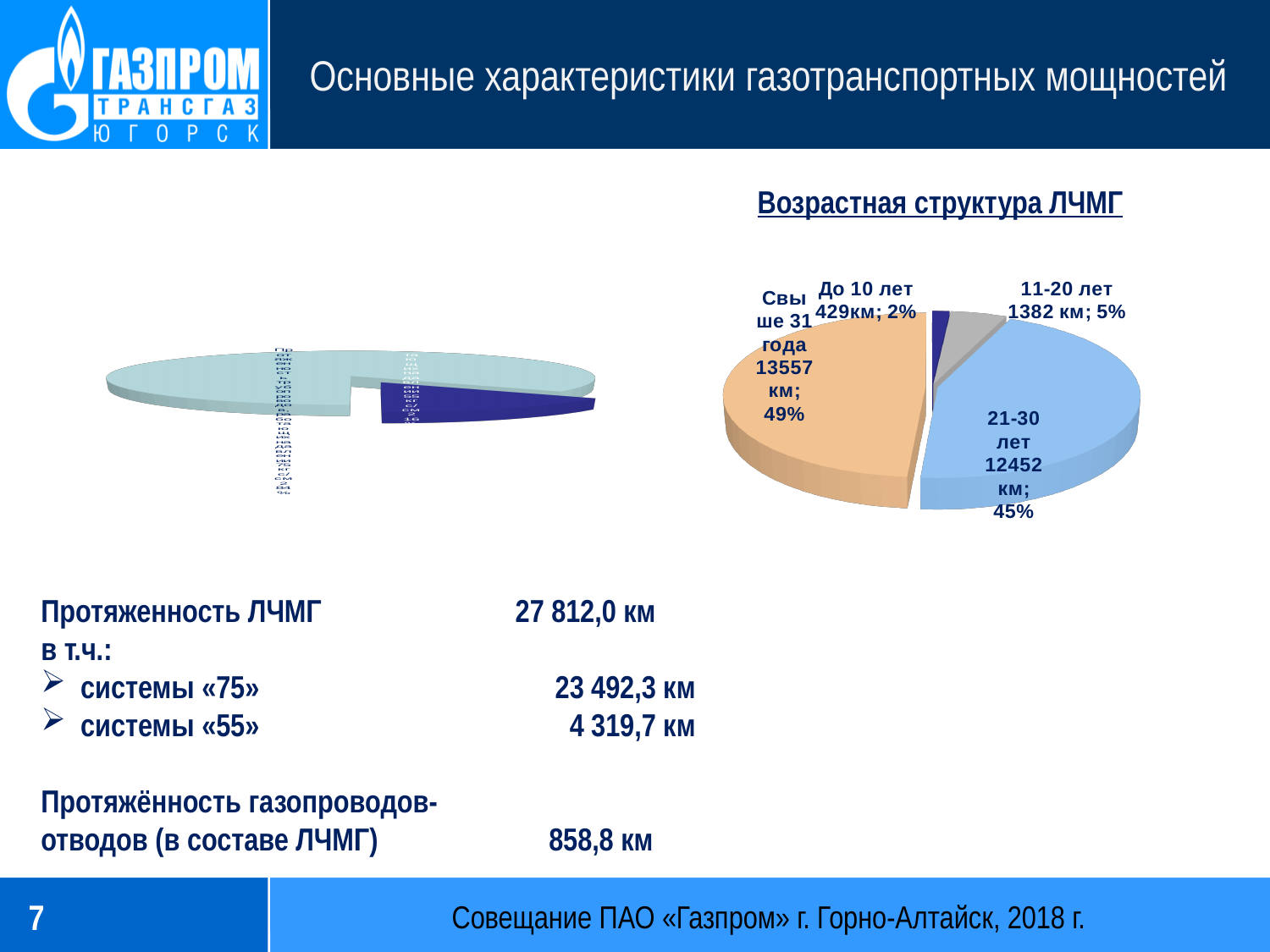
In the chart titled «Возрастная структура ЛЧМГ», which age category has the largest slice? Свыше 31 года In the chart titled «Возрастная структура ЛЧМГ», what length is shown for the «До 10 лет» slice? 429км What kind of chart is the chart titled «Возрастная структура ЛЧМГ»? Pie chart In the chart titled «Возрастная структура ЛЧМГ», what is the difference in length between «Свыше 31 года» and «21-30 лет»? 1105 км How many age categories are shown in the chart titled «Возрастная структура ЛЧМГ»? 4 In the chart titled «Возрастная структура ЛЧМГ», what length is shown for the «21-30 лет» slice? 12452 км In the chart titled «Возрастная структура ЛЧМГ», what is the difference in length between «21-30 лет» and «11-20 лет»? 11070 км In the chart titled «Возрастная структура ЛЧМГ», which age category has the smallest slice? До 10 лет What kind of chart is the chart on the left side of the slide? Pie chart In the chart titled «Возрастная структура ЛЧМГ», which is larger: the «11-20 лет» slice or the «До 10 лет» slice? 11-20 лет In the chart titled «Возрастная структура ЛЧМГ», what percentage share does the «Свыше 31 года» slice have? 49% In the chart titled «Возрастная структура ЛЧМГ», what percentage share does the «11-20 лет» slice have? 5%